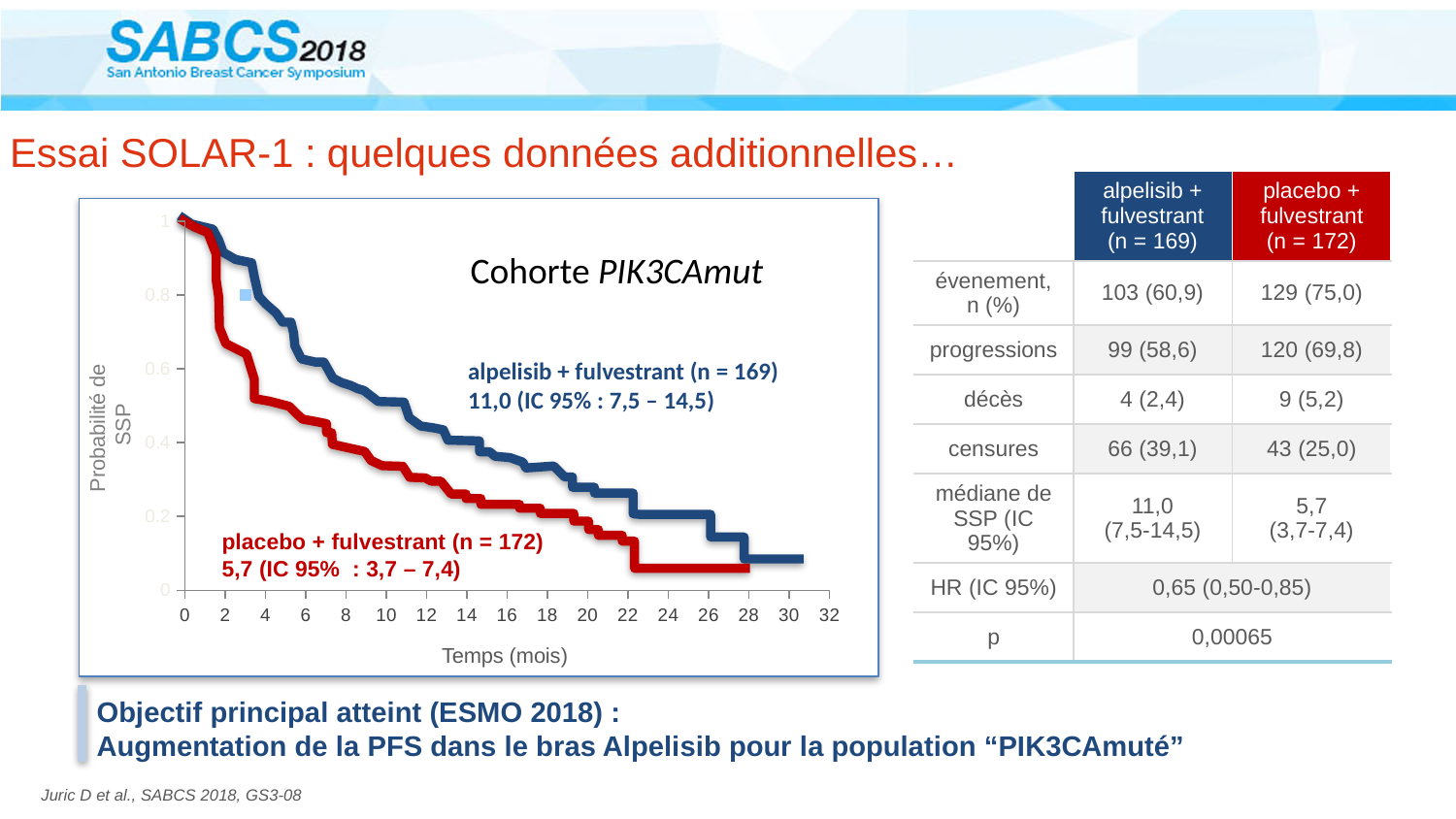
What is the 95% confidence interval printed on the chart for the alpelisib + fulvestrant median? 7,5 – 14,5 What is the 95% confidence interval printed on the chart for the placebo + fulvestrant median? 3,7 – 7,4 At 10 months, is the probability for the placebo + fulvestrant curve greater or less than 0.4? less Which colour is used for the alpelisib + fulvestrant curve? blue Which arm has the higher median PFS on the chart, alpelisib + fulvestrant or placebo + fulvestrant? alpelisib + fulvestrant How many series (treatment arms) are plotted on the chart? 2 What is the difference between the median PFS of alpelisib + fulvestrant and placebo + fulvestrant as printed on the chart? 5,3 What is the label of the x axis of the chart? Temps (mois) What is the median PFS printed on the chart for placebo + fulvestrant? 5,7 Do the survival curves rise or fall as time increases along the x axis? fall What is the median PFS printed on the chart for alpelisib + fulvestrant? 11,0 What kind of chart is shown on the slide? line chart